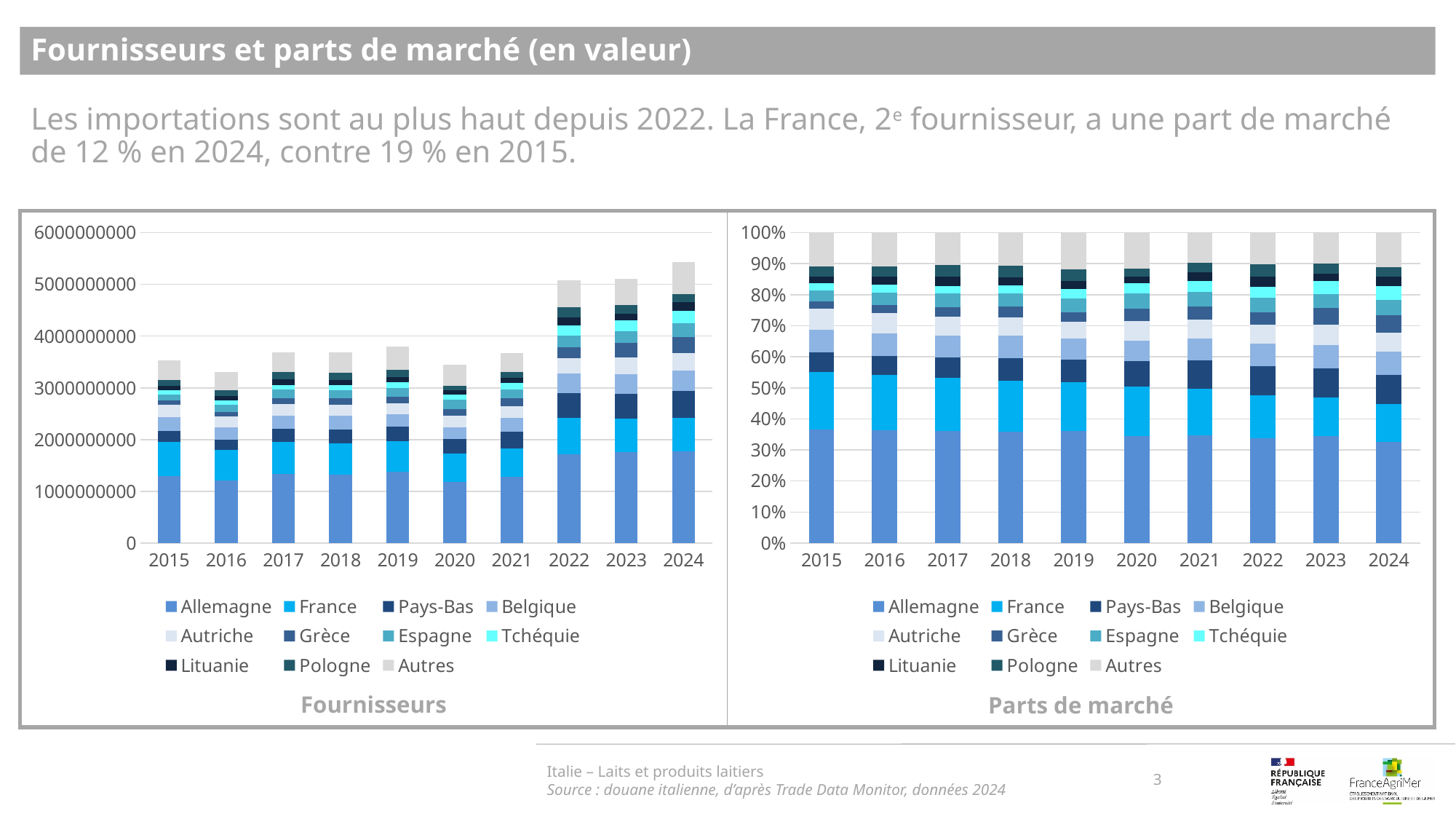
In the 'Parts de marché' chart, is the share for Allemagne in 2024 greater or less than 40%? less What is the title of the chart on the right of the slide? Parts de marché In the 'Fournisseurs' chart, is the total for 2016 greater or less than 4000000000? less In the 'Fournisseurs' chart, do the total bars rise or fall from 2021 to 2022? rise In the 'Parts de marché' chart, does the Allemagne share rise or fall from 2015 to 2024? fall How many years are shown on the x axis of the 'Parts de marché' chart? 10 How many series does the legend of the 'Fournisseurs' chart list? 11 In the 'Fournisseurs' chart, is the total for 2024 greater or less than 5000000000? greater In the 'Fournisseurs' chart, which year has the highest total bar? 2024 What kind of chart is the 'Fournisseurs' chart on the left? stacked bar chart In the 'Fournisseurs' chart, which total is larger, 2021 or 2022? 2022